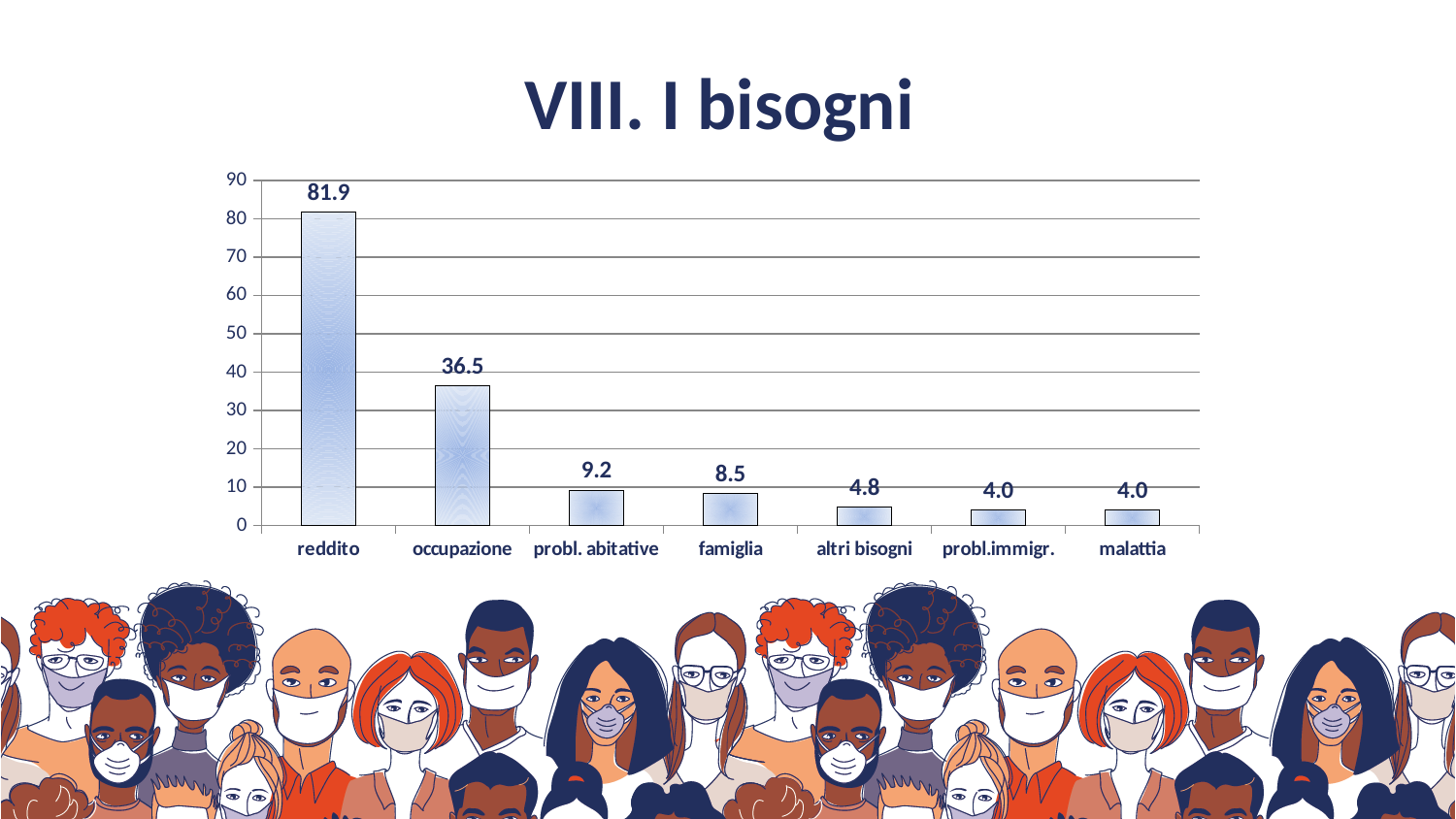
What is the difference between the values for reddito and occupazione? 45.4 How many categories are shown on the x axis? 7 What is the value for occupazione? 36.5 What is the title of the slide? VIII. I bisogni Is the value for occupazione greater or less than 40? less Which is larger, the value for probl. abitative or the value for famiglia? probl. abitative What is the value for famiglia? 8.5 What is the value for probl. abitative? 9.2 What kind of chart is shown on the slide? bar chart What is the value for altri bisogni? 4.8 What is the value for reddito? 81.9 Which category has the highest value? reddito